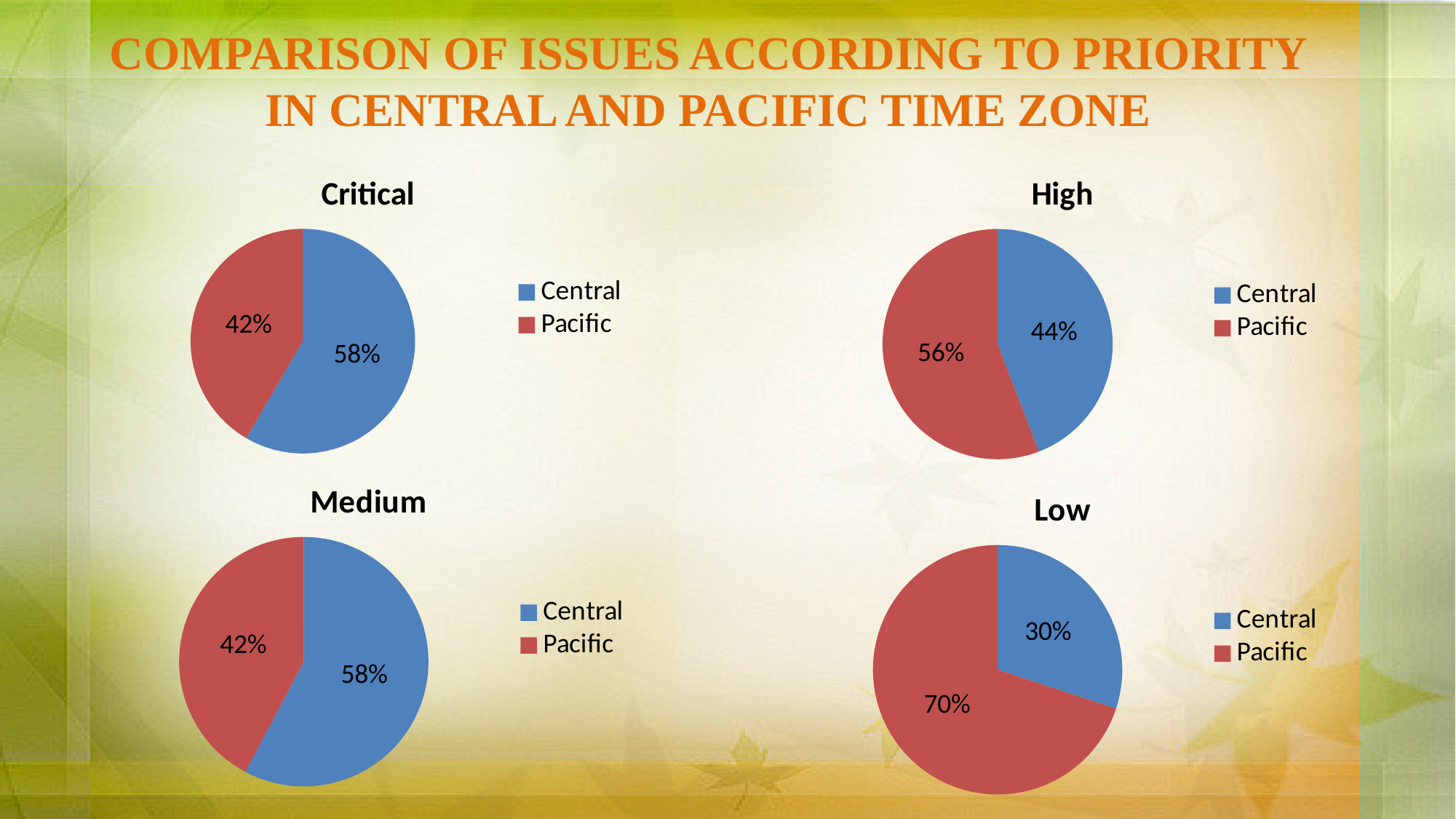
How many entries does the legend of the Low chart list? 2 In the Low chart, what is the value for Central? 30% In the High chart, which is larger, Central or Pacific? Pacific In the Critical chart, what is the value for Central? 58% In the Low chart, what is the difference between the Pacific and Central values? 40% In the High chart, what is the value for Pacific? 56% In the Critical chart, which category has the smallest slice? Pacific In the Critical chart, what colour represents Central? Blue What kind of chart is the Medium chart? Pie chart How many slices does the High chart have? 2 In the Low chart, which category has the largest slice? Pacific In the Medium chart, what is the value for Pacific? 42%